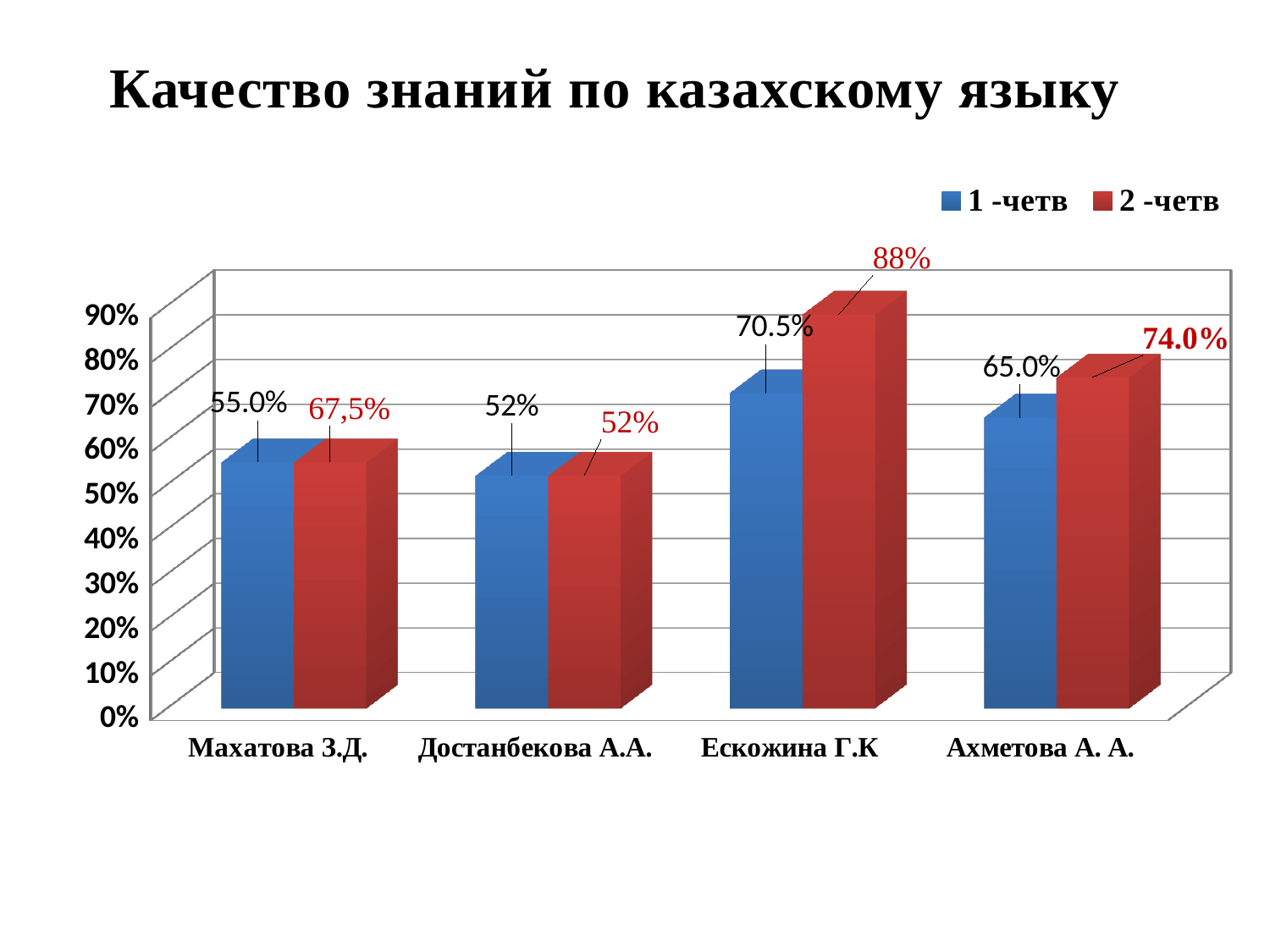
What kind of chart is shown on the slide? Bar chart What is the value for Ескожина Г.К in the 1 -четв series? 70.5% How many categories are shown on the x axis? 4 What is the value for Достанбекова А.А. in the 1 -четв series? 52% Which category has the lowest value in the 1 -четв series? Достанбекова А.А. What is the title of the chart? Качество знаний по казахскому языку How many series does the legend list? 2 Which is larger for Ахметова А. А.: the 1 -четв value or the 2 -четв value? 2 -четв What is the value for Ахметова А. А. in the 2 -четв series? 74.0% Which category has the highest value in the 2 -четв series? Ескожина Г.К What is the value for Махатова З.Д. in the 2 -четв series? 67,5% What is the difference between the 2 -четв and 1 -четв values for Ескожина Г.К? 17.5 percentage points